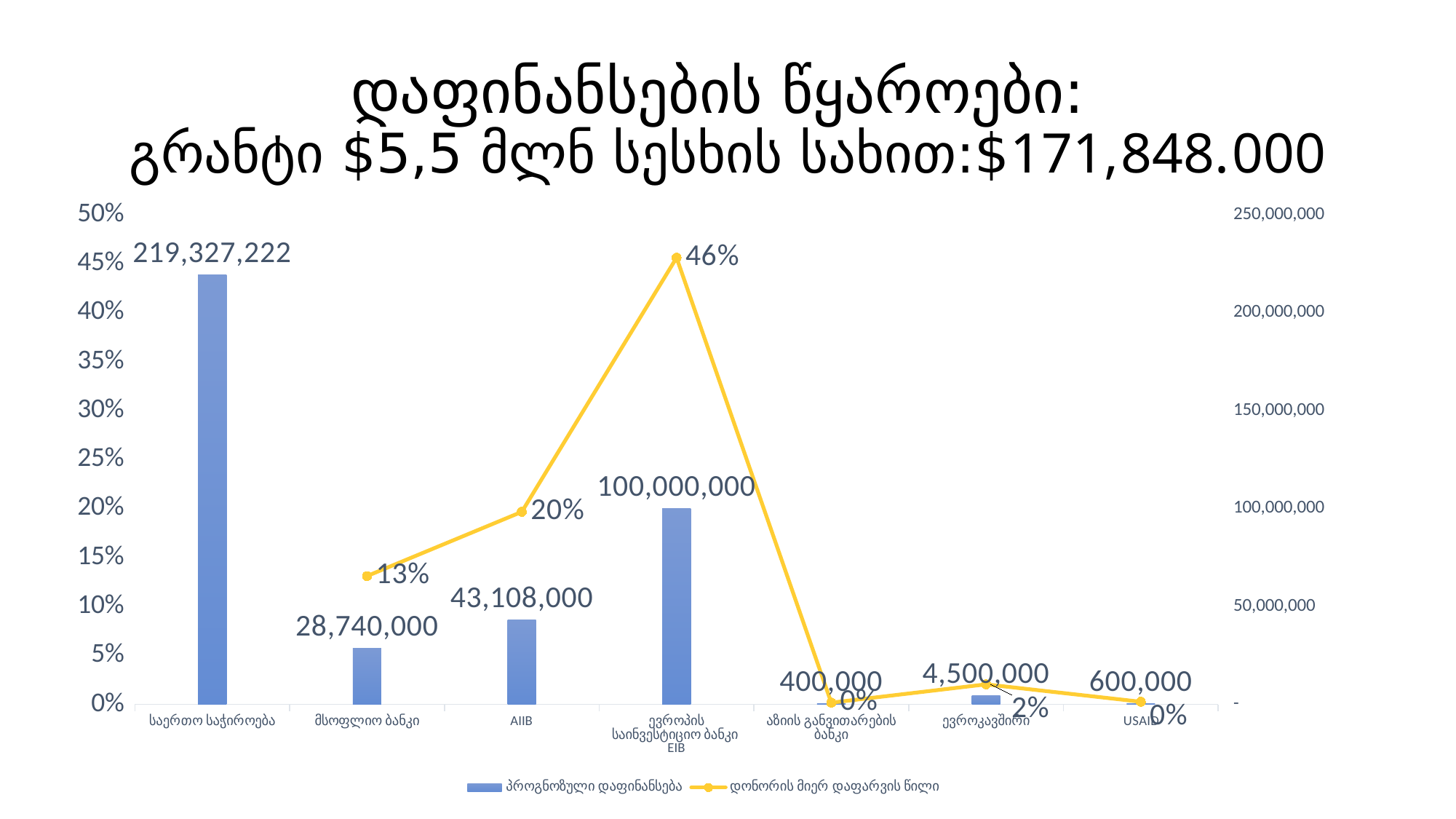
Which category has the lowest projected financing bar? აზიის განვითარების ბანკი What is the projected financing (პროგნოზული დაფინანსება) value for AIIB? 43,108,000 What is the donor coverage share for ევროკავშირი? 2% Which category has the highest projected financing bar? საერთო საჭიროება What is the difference between the projected financing for AIIB and for მსოფლიო ბანკი? 14,368,000 How many series does the legend list? 2 What is the projected financing value for USAID? 600,000 What kind of chart is shown on the slide? Combined bar and line chart What is the donor coverage share (დონორის მიერ დაფარვის წილი) for ევროპის საინვესტიციო ბანკი EIB? 46% What is the projected financing value for მსოფლიო ბანკი? 28,740,000 Which has a larger donor coverage share, AIIB or მსოფლიო ბანკი? AIIB How many categories are shown on the x axis? 7